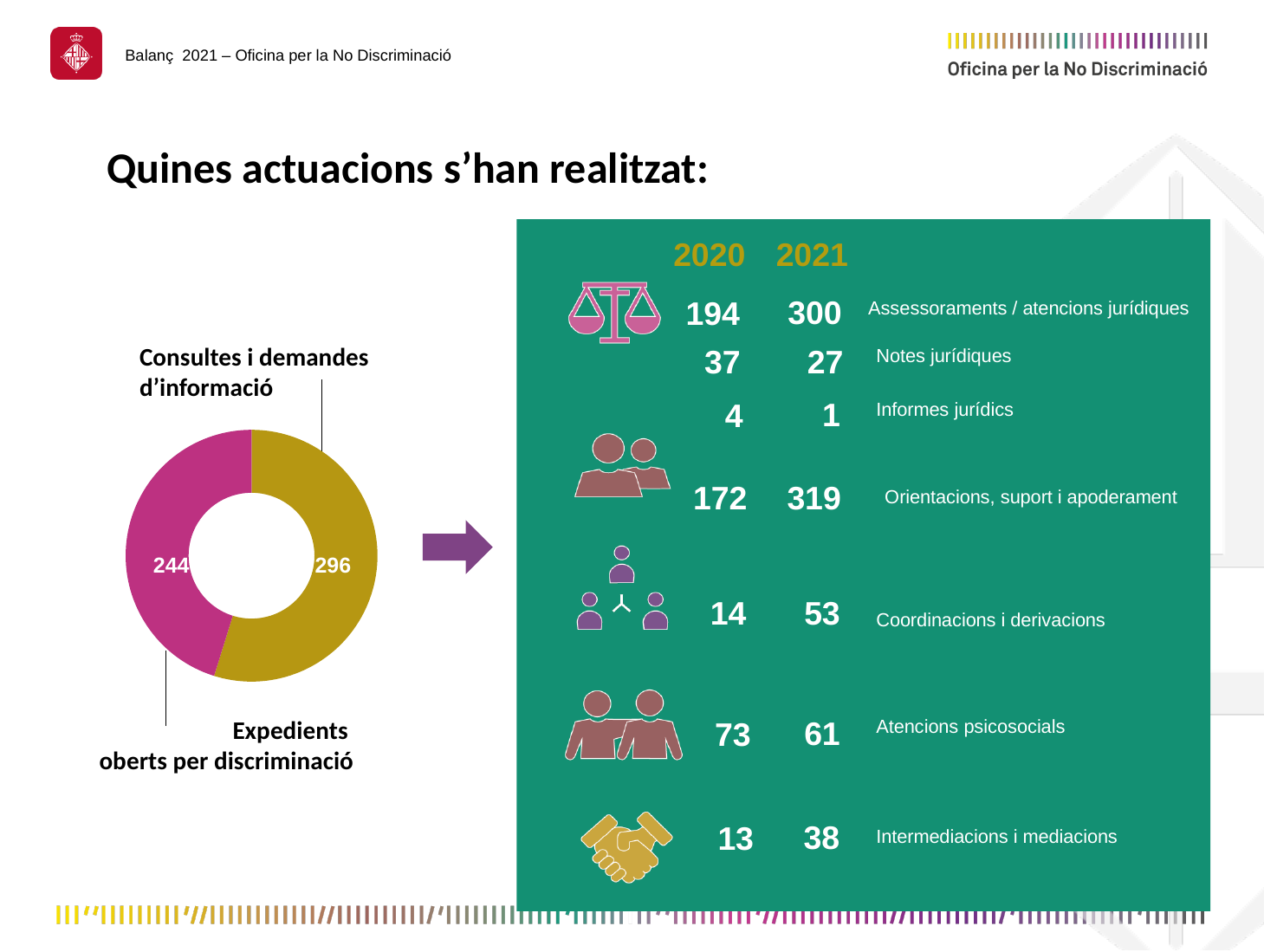
What is the difference between the values for Consultes i demandes d'informació and Expedients oberts per discriminació in the donut chart? 52 What is the total of the two values shown in the donut chart? 540 What kind of chart is shown on the left of the slide? Donut (pie) chart In the donut chart, what is the value for Expedients oberts per discriminació? 244 How many slices does the donut chart have? 2 What colour is the Consultes i demandes d'informació slice in the donut chart? Gold/yellow What colour is the Expedients oberts per discriminació slice in the donut chart? Magenta/pink Which slice of the donut chart is the smallest? Expedients oberts per discriminació In the donut chart, which is larger: Consultes i demandes d'informació or Expedients oberts per discriminació? Consultes i demandes d'informació In the donut chart, what is the value for Consultes i demandes d'informació? 296 Which slice of the donut chart is the largest? Consultes i demandes d'informació What share of the donut chart does Consultes i demandes d'informació represent? 54.8%